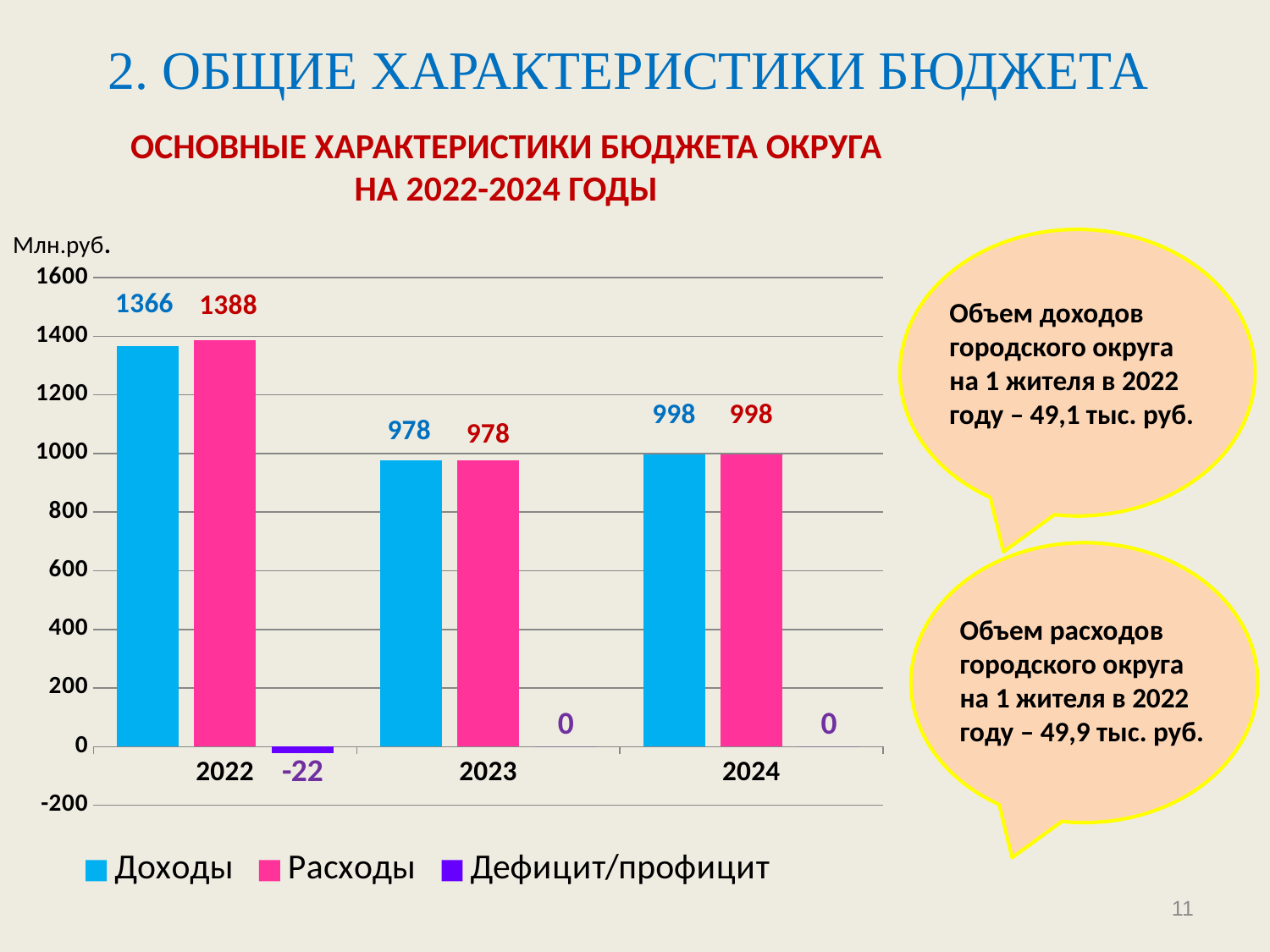
What unit is indicated above the chart's vertical axis? Млн.руб. How many series does the legend list? 3 Which is larger in 2022: Доходы or Расходы? Расходы What is the value of Доходы for 2022? 1366 What is the value of Доходы for 2024? 998 Which year has the highest value for Расходы? 2022 What kind of chart is shown on the slide? bar chart What is the difference between Расходы and Доходы in 2022? 22 What is the value of Дефицит/профицит for 2022? -22 What is the value of Расходы for 2022? 1388 Which year has the lowest value for Доходы? 2023 How many years are shown on the x axis? 3